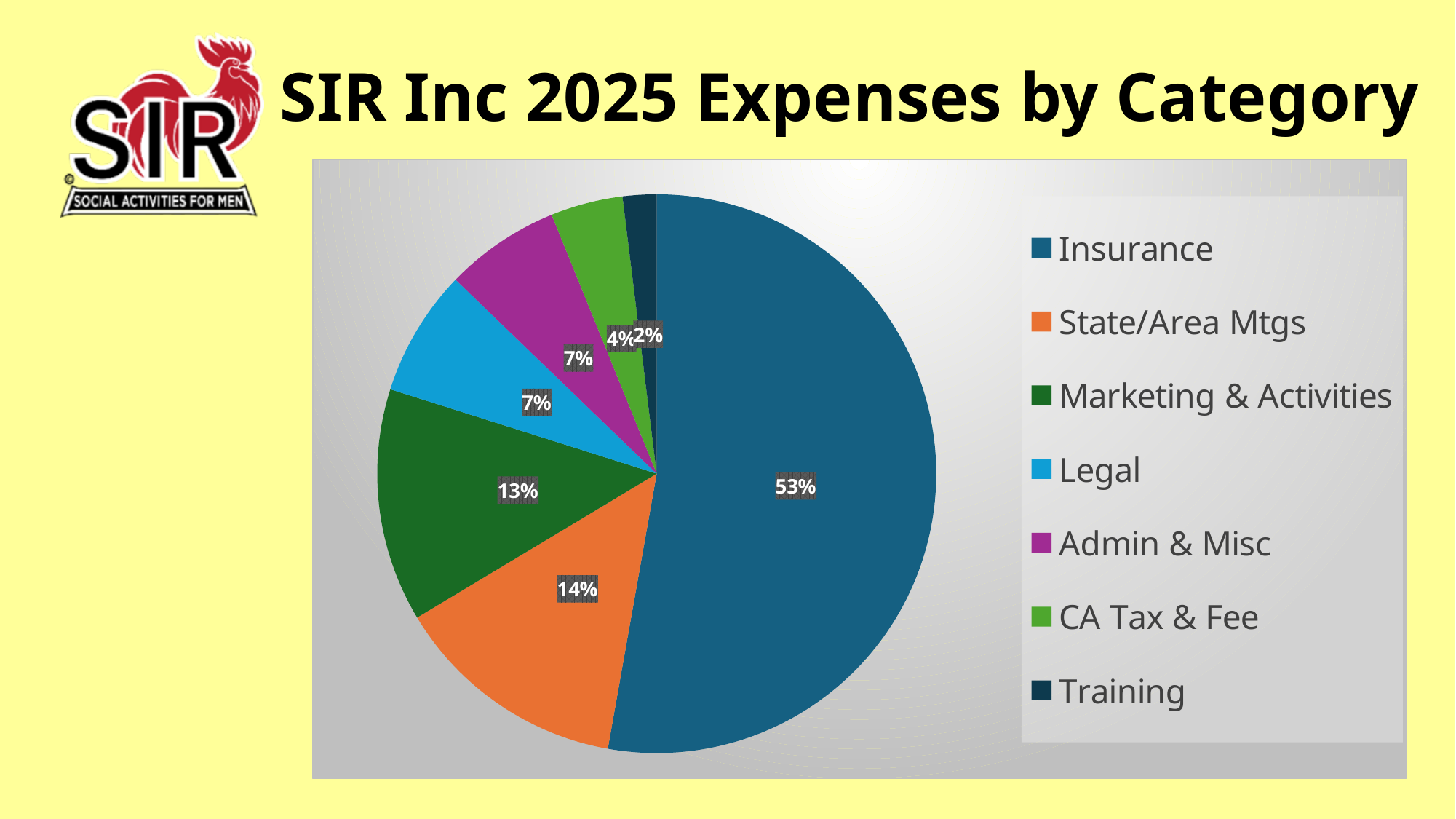
What is the difference in percentage points between Insurance and State/Area Mtgs? 39 What percentage of expenses is CA Tax & Fee? 4% What percentage of expenses is State/Area Mtgs? 14% What percentage of expenses is Marketing & Activities? 13% What share of expenses does Insurance account for? 53% Which is larger, the share for Marketing & Activities or the share for Legal? Marketing & Activities What colour is the Admin & Misc slice? purple How many categories are shown in the pie chart? 7 Which category has the largest share of expenses? Insurance Which category has the smallest share of expenses? Training What kind of chart is shown on the slide? pie chart What is the title of the slide? SIR Inc 2025 Expenses by Category